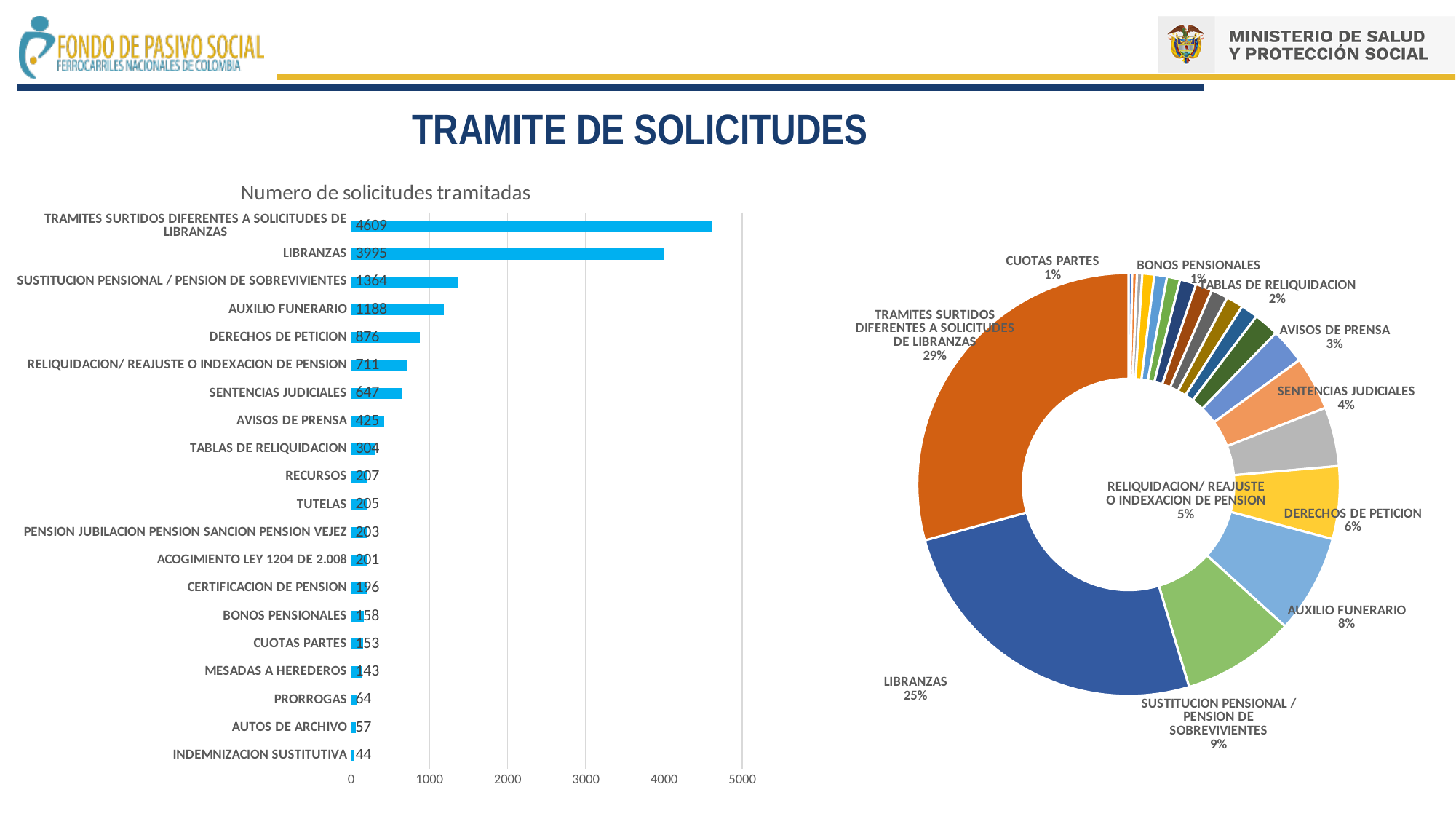
In the doughnut chart on the right, what share does AUXILIO FUNERARIO have? 8% In the bar chart 'Numero de solicitudes tramitadas', what is the value for LIBRANZAS? 3995 How many categories are shown in the bar chart 'Numero de solicitudes tramitadas'? 20 In the bar chart 'Numero de solicitudes tramitadas', which category has the lowest value? INDEMNIZACION SUSTITUTIVA What kind of chart is the chart titled 'Numero de solicitudes tramitadas'? bar chart In the bar chart 'Numero de solicitudes tramitadas', what is the value for AUXILIO FUNERARIO? 1188 In the bar chart 'Numero de solicitudes tramitadas', which is larger: DERECHOS DE PETICION or SENTENCIAS JUDICIALES? DERECHOS DE PETICION In the doughnut chart on the right, what share does LIBRANZAS have? 25% In the bar chart 'Numero de solicitudes tramitadas', is the value for SUSTITUCION PENSIONAL / PENSION DE SOBREVIVIENTES greater or less than 1000? greater In the bar chart 'Numero de solicitudes tramitadas', which category has the highest value? TRAMITES SURTIDOS DIFERENTES A SOLICITUDES DE LIBRANZAS In the bar chart 'Numero de solicitudes tramitadas', what is the difference between the values for TRAMITES SURTIDOS DIFERENTES A SOLICITUDES DE LIBRANZAS and LIBRANZAS? 614 In the doughnut chart on the right, which category has the largest share? TRAMITES SURTIDOS DIFERENTES A SOLICITUDES DE LIBRANZAS